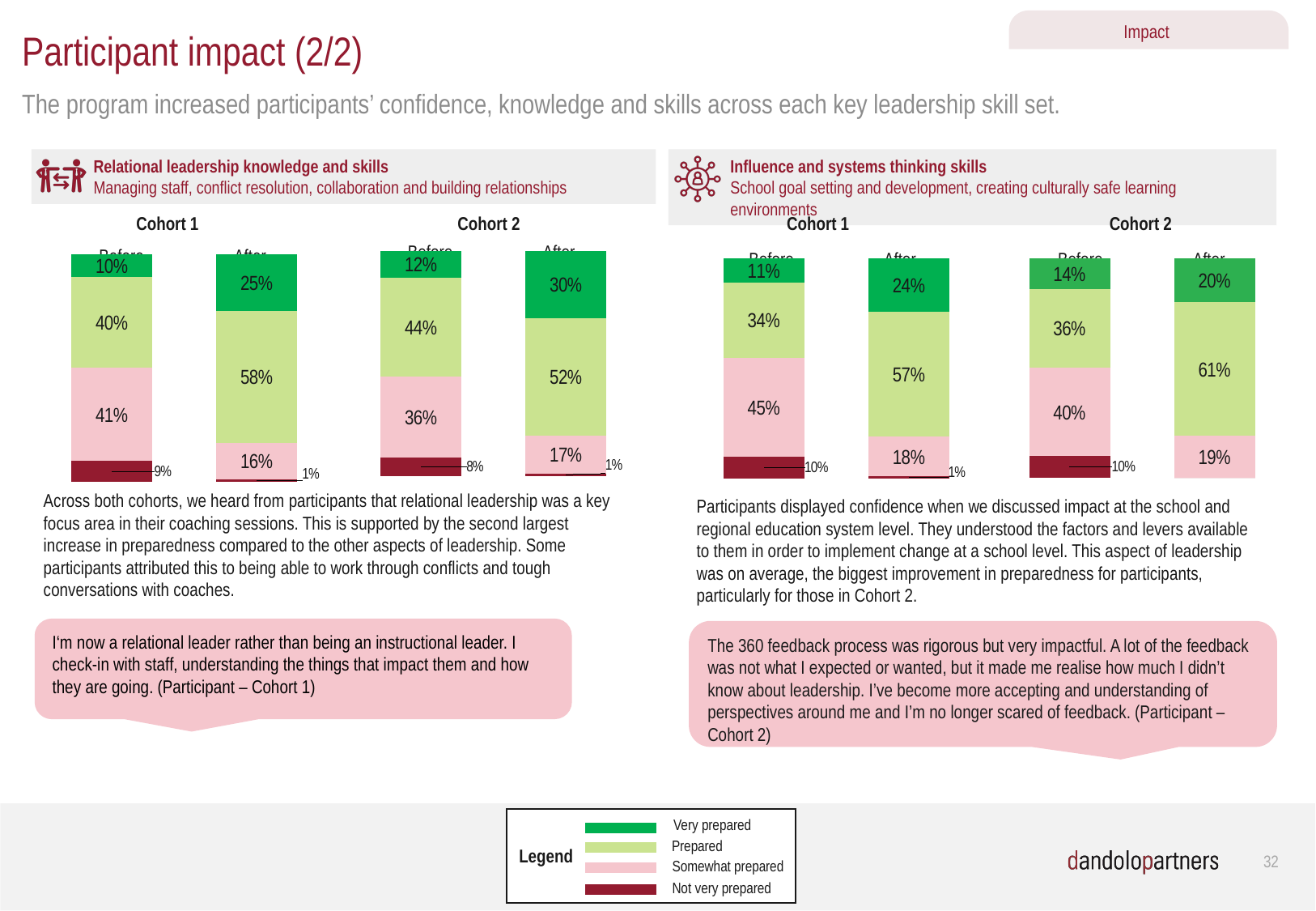
In the Relational leadership knowledge and skills chart, which segment is the smallest in the Cohort 1 Before bar? Not very prepared (9%) What type of chart is used to show participant preparedness on this slide? Stacked bar chart In the Relational leadership knowledge and skills chart, what share of Cohort 2 participants were 'Prepared' before the program? 44% In the Influence and systems thinking skills chart, which segment is the largest in the Cohort 1 After bar? Prepared (57%) In the Relational leadership knowledge and skills chart, which is larger: the 'Very prepared' share for Cohort 1 After or for Cohort 2 After? Cohort 2 After In the Relational leadership knowledge and skills chart, what share of Cohort 1 participants were 'Very prepared' after the program? 25% In the Influence and systems thinking skills chart, what share of Cohort 2 participants were 'Prepared' after the program? 61% In the Influence and systems thinking skills chart, what is the 'Not very prepared' share for Cohort 2 before the program? 10% How many preparedness categories does the legend list? 4 In the Influence and systems thinking skills chart, by how many percentage points did the 'Somewhat prepared' share for Cohort 1 fall from Before to After? 27 percentage points In the Influence and systems thinking skills chart, what share of Cohort 1 participants were 'Somewhat prepared' before the program? 45% In the Relational leadership knowledge and skills chart, by how many percentage points did the 'Very prepared' share for Cohort 2 change from Before to After? 18 percentage points